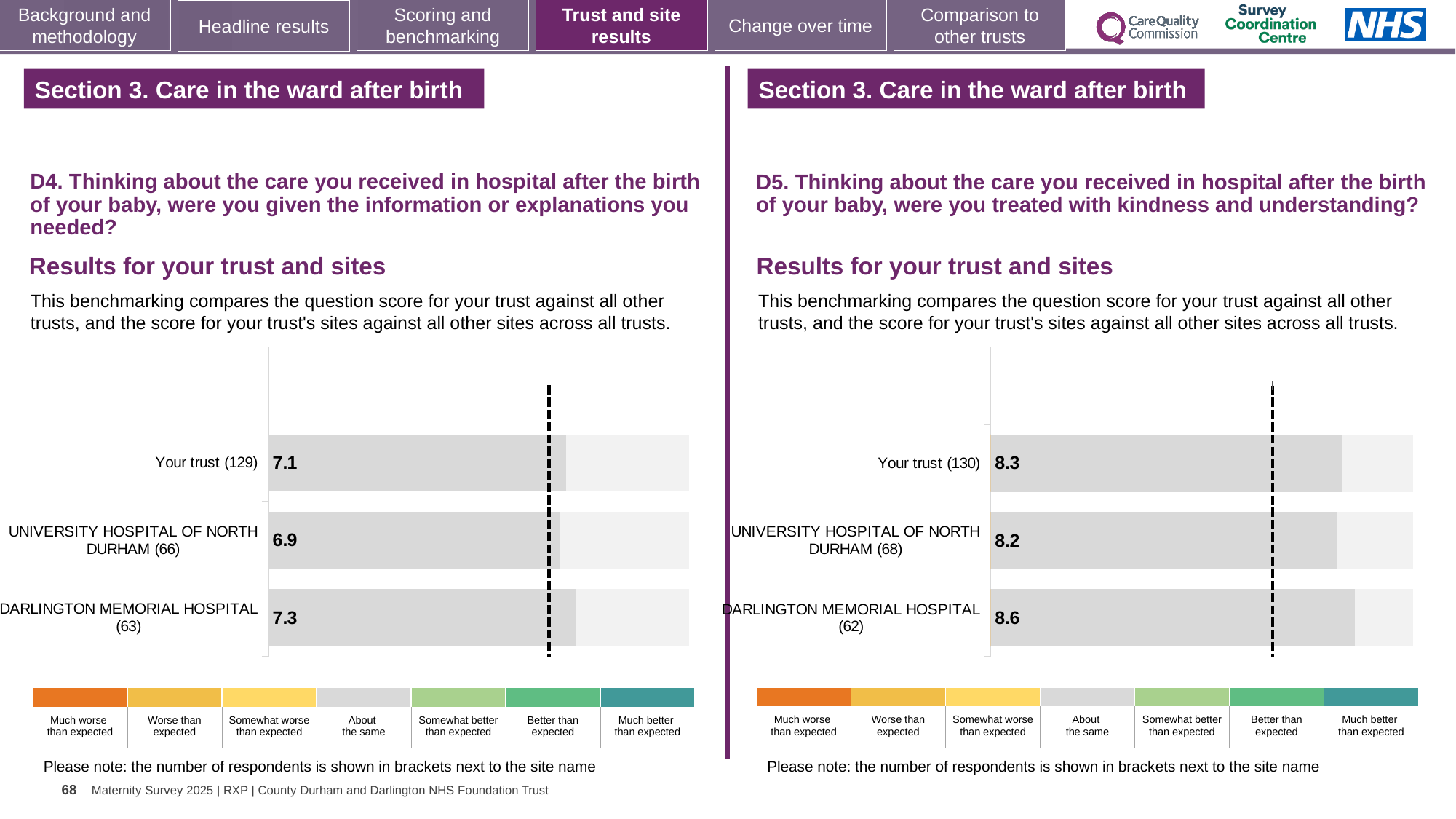
How many bars are plotted on the left chart (D4)? 3 On the left chart (D4), what is the score for Darlington Memorial Hospital? 7.3 What type of chart is used on the right (D5)? Bar chart On the right chart (D5), which site or trust has the highest score? Darlington Memorial Hospital On the right chart (D5), what is the score for Your trust? 8.3 On the left chart (D4), which has the larger score: Your trust or Darlington Memorial Hospital? Darlington Memorial Hospital On the right chart (D5), what is the difference between the scores for Darlington Memorial Hospital and University Hospital of North Durham? 0.4 On the left chart (D4), which site or trust has the lowest score? University Hospital of North Durham On the left chart (D4), what is the score for Your trust? 7.1 On the left chart (D4), what is the score for University Hospital of North Durham? 6.9 On the right chart (D5), how many respondents are shown in brackets for Your trust? 130 On the right chart (D5), what is the score for Darlington Memorial Hospital? 8.6